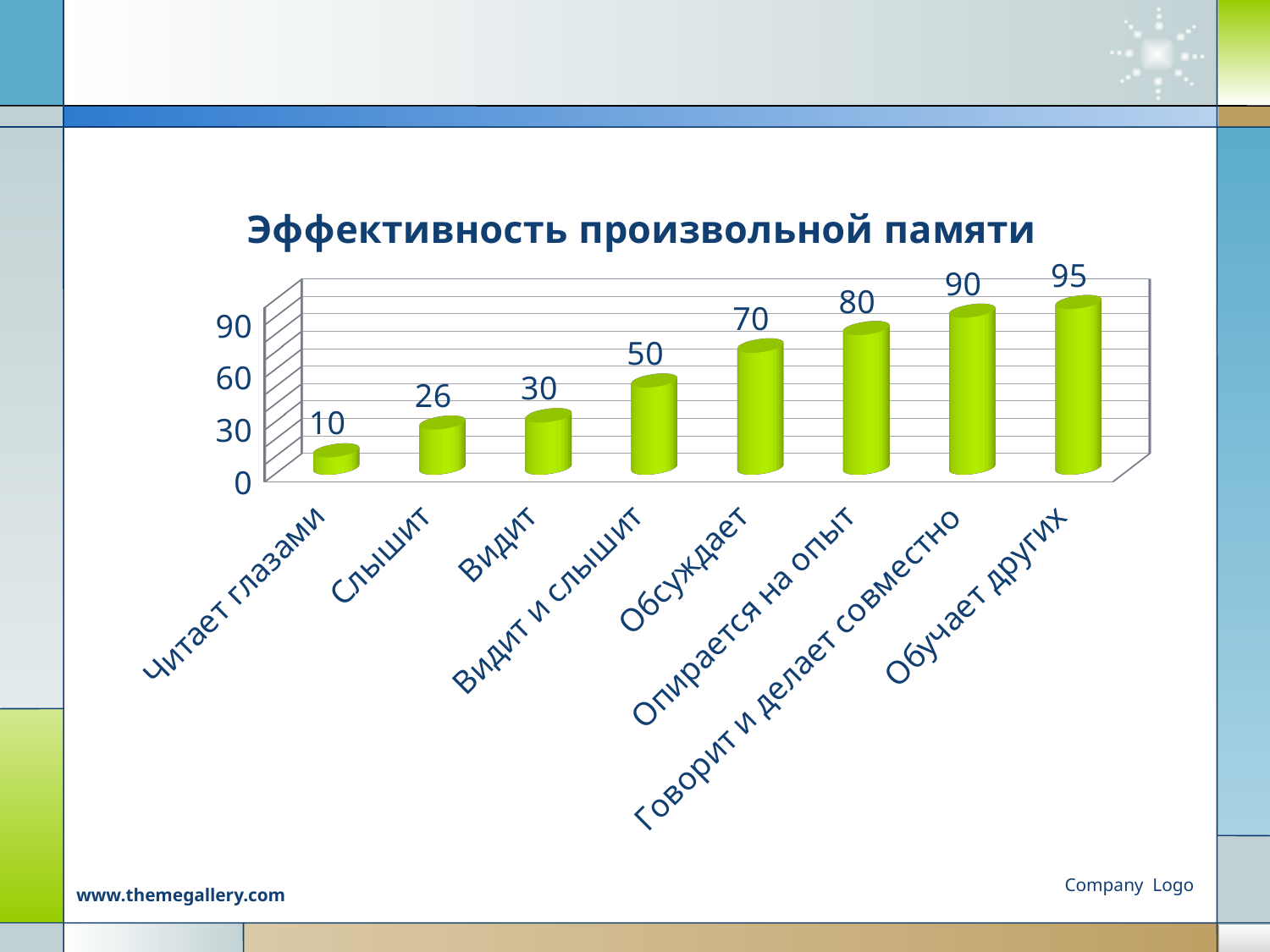
What is the difference between the values for "Видит и слышит" and "Видит"? 20 Which is larger, the value for "Опирается на опыт" or the value for "Обсуждает"? Опирается на опыт Which category has the highest value? Обучает других What is the value for "Говорит и делает совместно"? 90 What is the value for "Слышит"? 26 What is the value for "Читает глазами"? 10 What kind of chart is shown on the slide? Bar chart How many categories are shown on the chart? 8 What is the difference between the values for "Обучает других" and "Читает глазами"? 85 Do the values rise or fall from left to right along the x axis? Rise Which category has the lowest value? Читает глазами What is the value for "Обсуждает"? 70